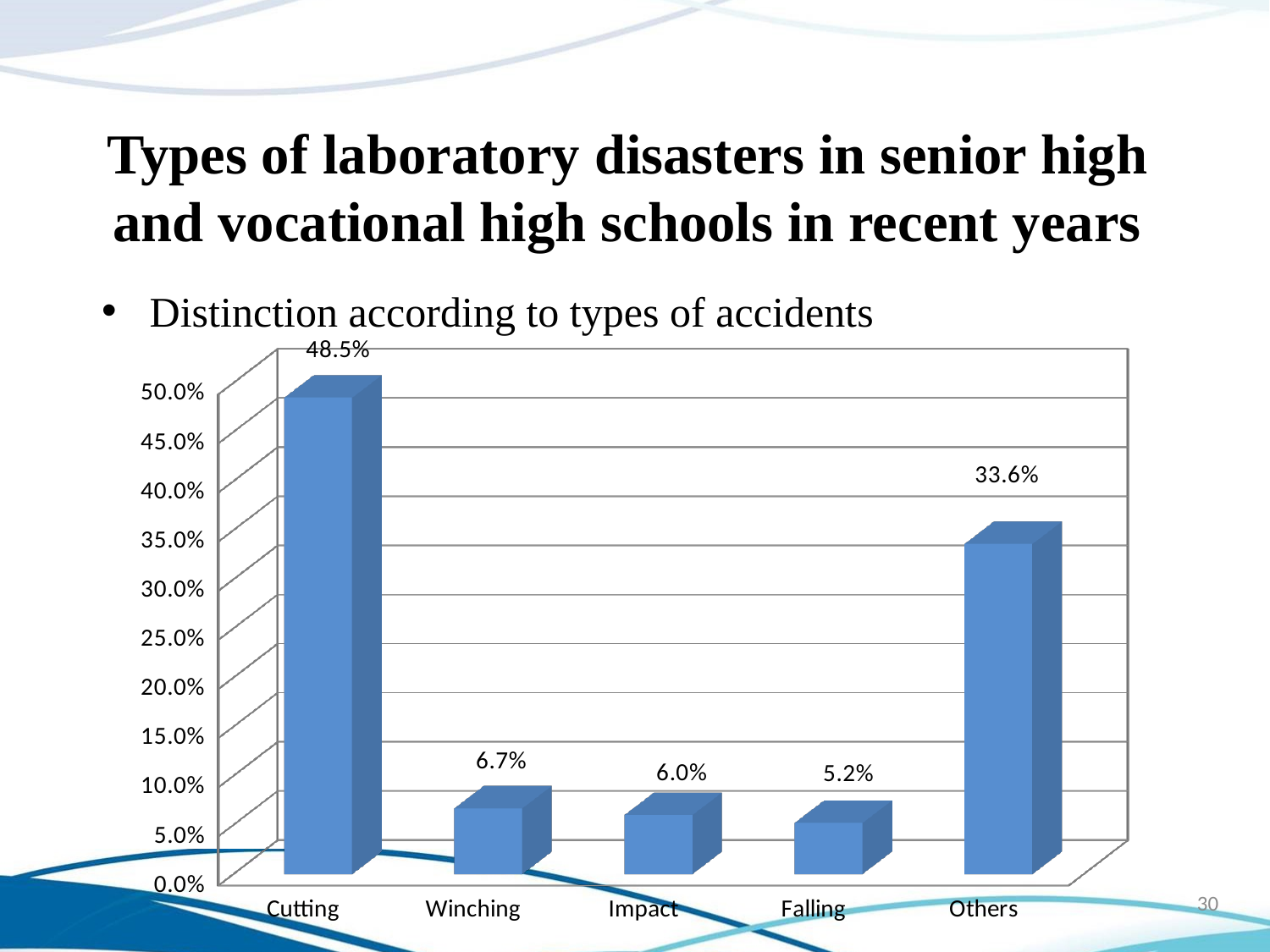
What is the difference between the values for Cutting and Others? 14.9% What is the value for Winching? 6.7% What is the value for Others? 33.6% What is the value for Falling? 5.2% How many categories are shown on the x axis? 5 What is the difference between the values for Winching and Impact? 0.7% What is the value for Cutting? 48.5% Which is larger, the value for Impact or the value for Others? Others Which category has the lowest value? Falling What kind of chart is shown on the slide? Bar chart Which category has the highest value? Cutting Is the value for Others greater or less than 30.0%? greater